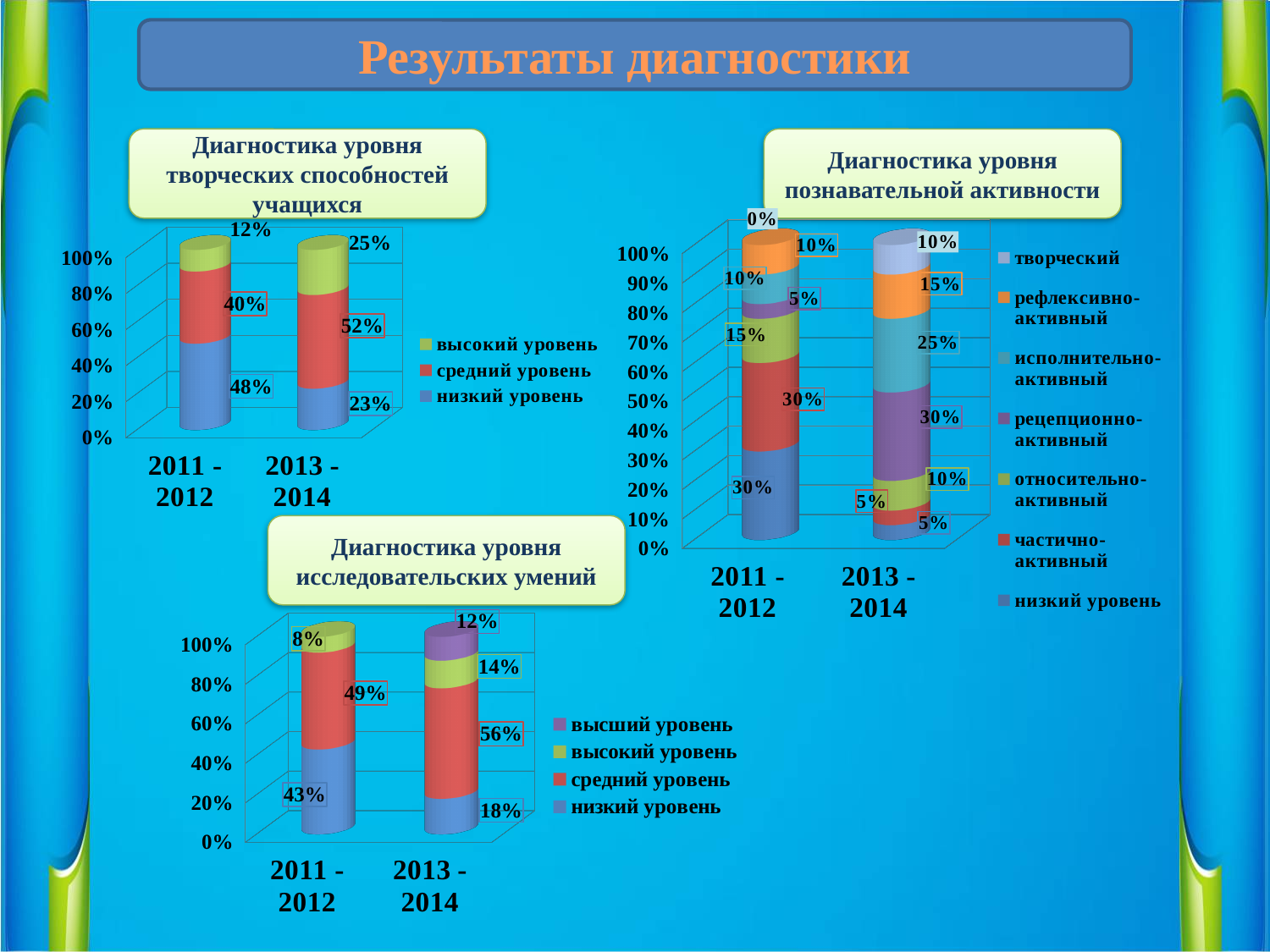
In the chart 'Диагностика уровня творческих способностей учащихся', what is the value of 'высокий уровень' for 2013-2014? 25% In the chart 'Диагностика уровня познавательной активности', what is the value of 'рецепционно-активный' for 2013-2014? 30% In the chart 'Диагностика уровня творческих способностей учащихся', by how many percentage points did 'средний уровень' change from 2011-2012 to 2013-2014? 12% In the chart 'Диагностика уровня исследовательских умений', what is the value of 'высший уровень' for 2013-2014? 12% In the chart 'Диагностика уровня творческих способностей учащихся', what is the value of 'низкий уровень' for 2011-2012? 48% In the chart 'Диагностика уровня познавательной активности', how many series does the legend list? 7 In the chart 'Диагностика уровня исследовательских умений', which is larger: 'низкий уровень' in 2011-2012 or in 2013-2014? 2011-2012 In the chart 'Диагностика уровня исследовательских умений', how many series does the legend list? 4 In the chart 'Диагностика уровня творческих способностей учащихся', how many series does the legend list? 3 In the chart 'Диагностика уровня исследовательских умений', what is the value of 'средний уровень' for 2013-2014? 56% In the chart 'Диагностика уровня познавательной активности', what is the value of 'творческий' for 2011-2012? 0% What type of chart is 'Диагностика уровня познавательной активности'? Stacked bar chart